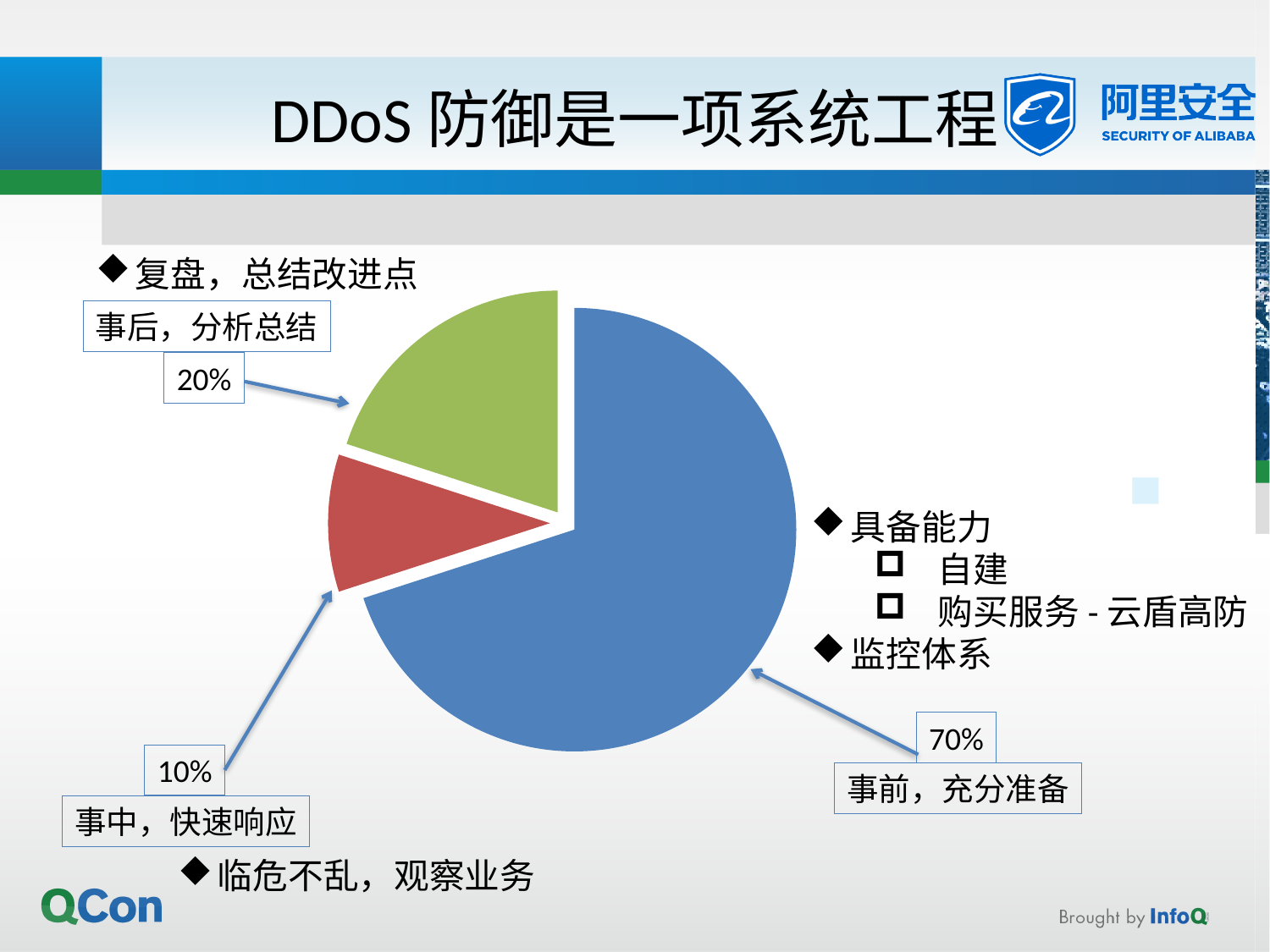
What colour is the slice labelled 事前，充分准备? blue What share of the pie is labelled 事前，充分准备? 70% What share of the pie is labelled 事后，分析总结? 20% How many slices does the pie chart have? 3 What is the title of the slide containing the pie chart? DDoS 防御是一项系统工程 Which slice of the pie chart is the smallest? 事中，快速响应 Which is larger, the share for 事后，分析总结 or the share for 事中，快速响应? 事后，分析总结 Which slice of the pie chart is the largest? 事前，充分准备 What share of the pie is labelled 事中，快速响应? 10% What kind of chart is shown on the slide? pie chart What is the difference between the shares for 事前，充分准备 and 事后，分析总结? 50% What is the combined share of 事中，快速响应 and 事后，分析总结? 30%